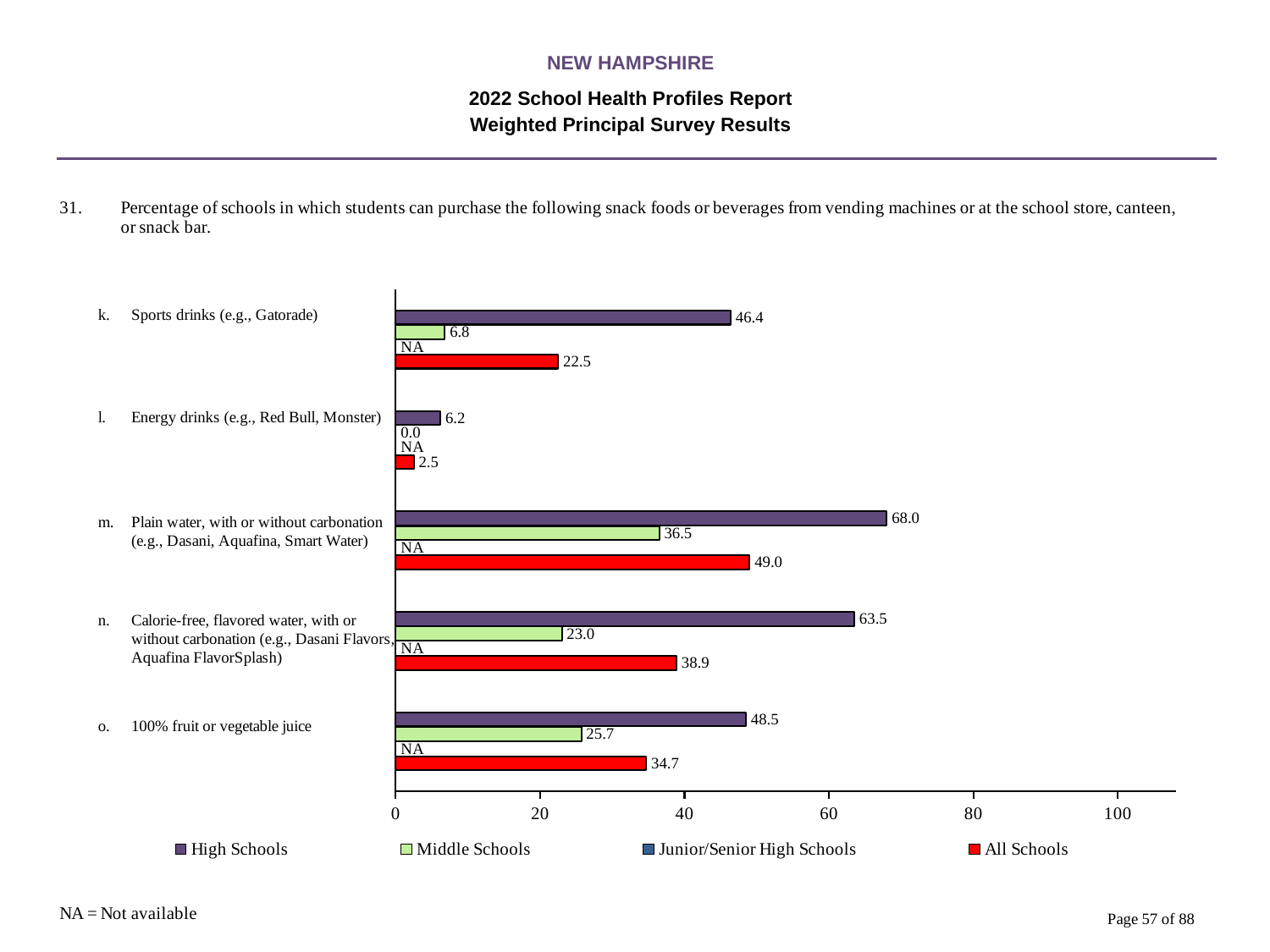
What is the value for Middle Schools for 100% fruit or vegetable juice? 25.7 What is the value for Middle Schools for Energy drinks (e.g., Red Bull, Monster)? 0.0 Which category has the highest High Schools value? Plain water, with or without carbonation What kind of chart is shown on the slide? Bar chart Which is larger: the All Schools value for Sports drinks or the All Schools value for 100% fruit or vegetable juice? 100% fruit or vegetable juice How many series does the legend list? 4 Which category has the lowest All Schools value? Energy drinks (e.g., Red Bull, Monster) What is the value for All Schools for Plain water, with or without carbonation? 49.0 What value is shown for Junior/Senior High Schools for Plain water, with or without carbonation? NA How many snack food or beverage categories are shown on the chart? 5 What is the difference between the High Schools and Middle Schools values for Calorie-free, flavored water? 40.5 What is the value for High Schools for Sports drinks (e.g., Gatorade)? 46.4